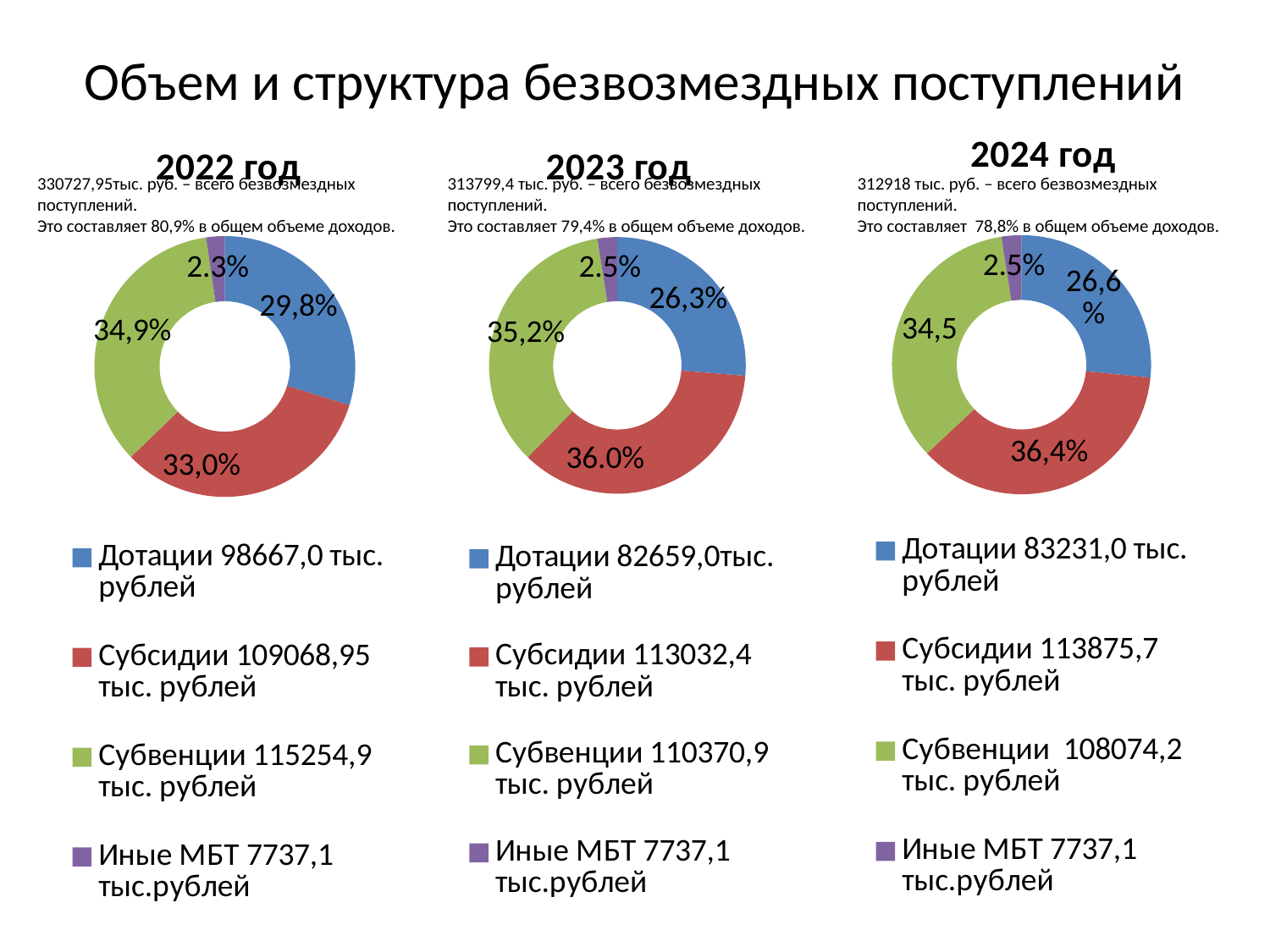
On the 2024 год chart, what amount in тыс. рублей does the legend give for Субсидии? 113875,7 тыс. рублей On the 2022 год chart, what is the difference between the Субвенции share and the Дотации share? 5,1% On the 2024 год chart, what share is shown for the Иные МБТ slice? 2.5% On the 2023 год chart, which colour represents Субвенции? Green On the 2024 год chart, which category has the smallest slice? Иные МБТ How many entries does the legend of the 2022 год chart list? 4 On the 2023 год chart, what share is shown for the Субсидии slice? 36.0% How many slices does the 2023 год chart have? 4 What kind of chart is used for 2024 год? Doughnut (pie) chart On the 2022 год chart, what share is shown for the Дотации slice? 29,8% On the 2023 год chart, which is larger: the Дотации slice or the Субвенции slice? Субвенции On the 2022 год chart, which category has the largest slice? Субвенции